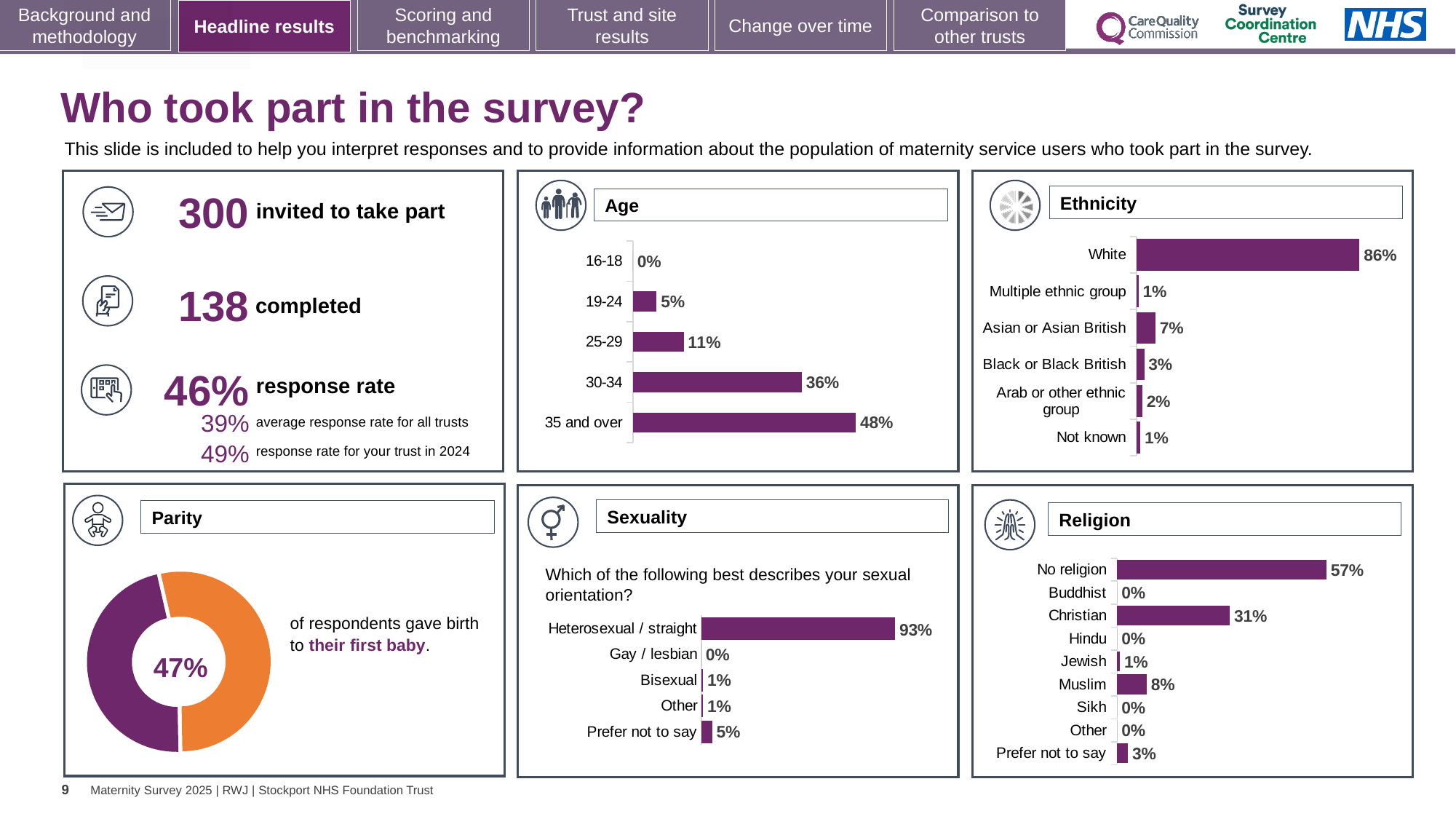
In the Age chart, what is the difference between the 30-34 and 25-29 percentages? 25% In the Ethnicity chart, what percentage of respondents were White? 86% In the Religion chart, what percentage of respondents were Christian? 31% In the Ethnicity chart, which is larger, Asian or Asian British or Black or Black British? Asian or Asian British What kind of chart is the Parity chart? Doughnut chart In the Age chart, which age group has the highest percentage? 35 and over In the Age chart, what percentage of respondents were aged 35 and over? 48% In the Sexuality chart, what percentage of respondents answered Prefer not to say? 5% How many categories does the Ethnicity chart show? 6 In the Religion chart, what is the difference between No religion and Muslim? 49% In the Religion chart, which category has the highest percentage? No religion In the Parity chart, what percentage of respondents gave birth to their first baby? 47%